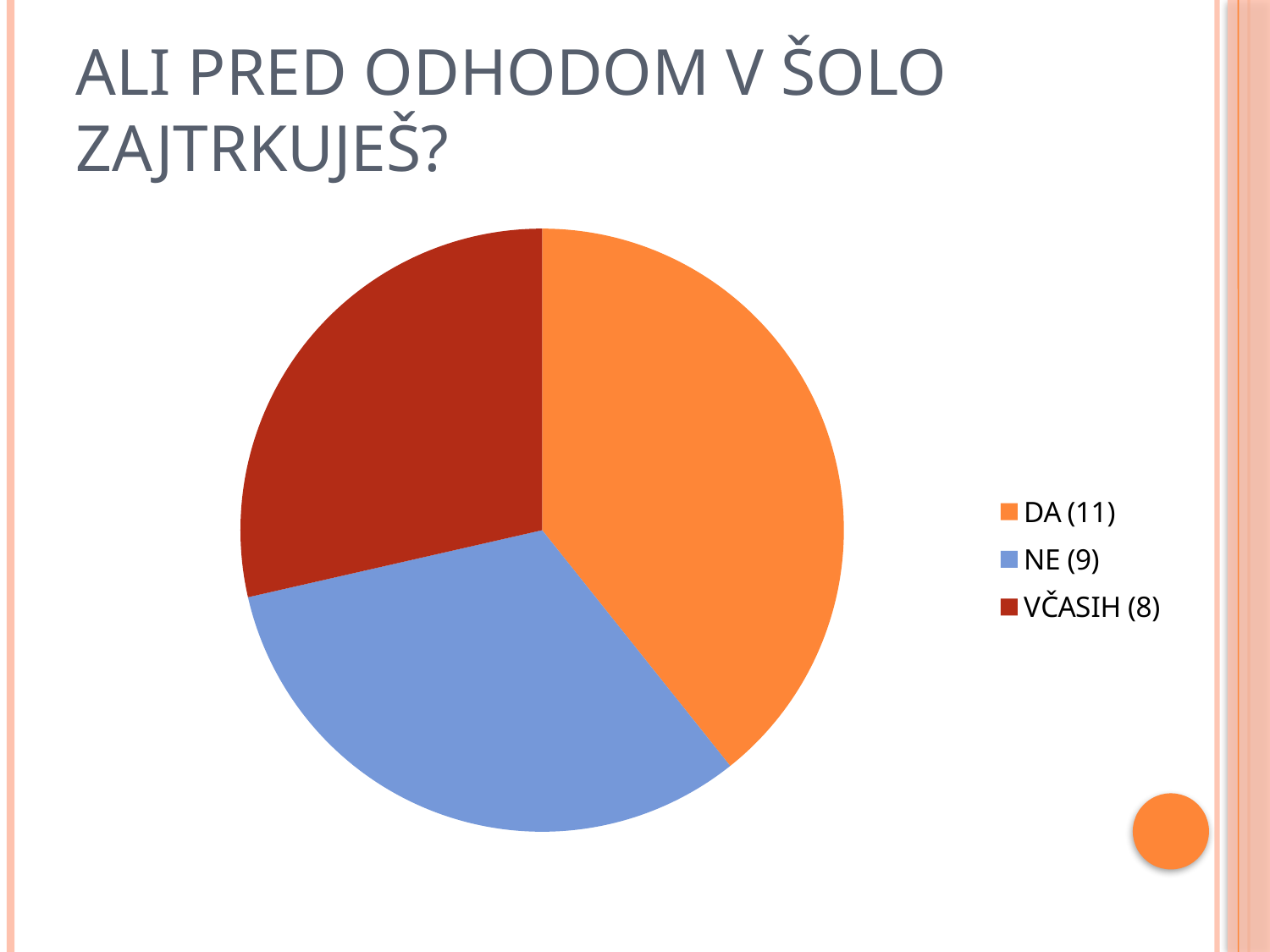
What colour is the slice for NE in the pie chart? blue What is the difference between the values for DA and NE? 2 What is the value for NE in the pie chart? 9 How many slices does the pie chart have? 3 What kind of chart is shown on the slide? pie chart What is the title of the slide containing the pie chart? ALI PRED ODHODOM V ŠOLO ZAJTRKUJEŠ? Which is larger, the value for NE or the value for VČASIH? NE What is the value for VČASIH in the pie chart? 8 Which category has the smallest slice of the pie chart? VČASIH What is the value for DA in the pie chart? 11 Which category has the largest slice of the pie chart? DA What is the difference between the values for DA and VČASIH? 3